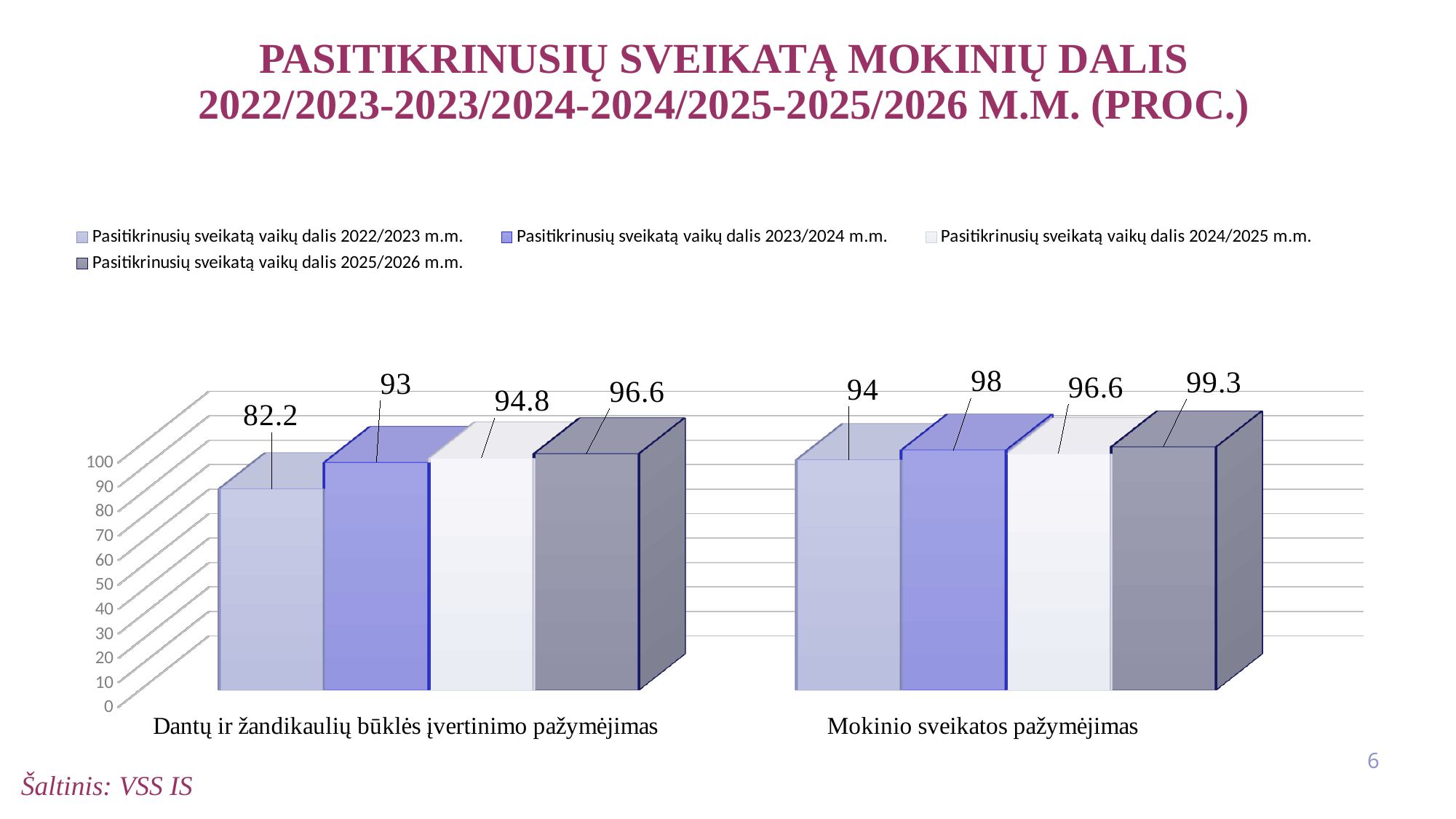
What is the difference between the 2023/2024 m.m. and 2024/2025 m.m. values for 'Mokinio sveikatos pažymėjimas'? 1.4 Which is larger for the 2024/2025 m.m. series: 'Dantų ir žandikaulių būklės įvertinimo pažymėjimas' or 'Mokinio sveikatos pažymėjimas'? Mokinio sveikatos pažymėjimas How many series does the legend list? 4 Which series has the lowest value for 'Dantų ir žandikaulių būklės įvertinimo pažymėjimas'? Pasitikrinusių sveikatą vaikų dalis 2022/2023 m.m. What is the difference between the 2025/2026 m.m. and 2022/2023 m.m. values for 'Dantų ir žandikaulių būklės įvertinimo pažymėjimas'? 14.4 How many categories are shown on the x axis? 2 What is the value for 'Mokinio sveikatos pažymėjimas' in the 2025/2026 m.m. series? 99.3 What kind of chart is shown on the slide? Bar chart Which series has the highest value for 'Mokinio sveikatos pažymėjimas'? Pasitikrinusių sveikatą vaikų dalis 2025/2026 m.m. What is the value for 'Dantų ir žandikaulių būklės įvertinimo pažymėjimas' in the 2022/2023 m.m. series? 82.2 What is the value for 'Mokinio sveikatos pažymėjimas' in the 2023/2024 m.m. series? 98 What is the value for 'Dantų ir žandikaulių būklės įvertinimo pažymėjimas' in the 2024/2025 m.m. series? 94.8